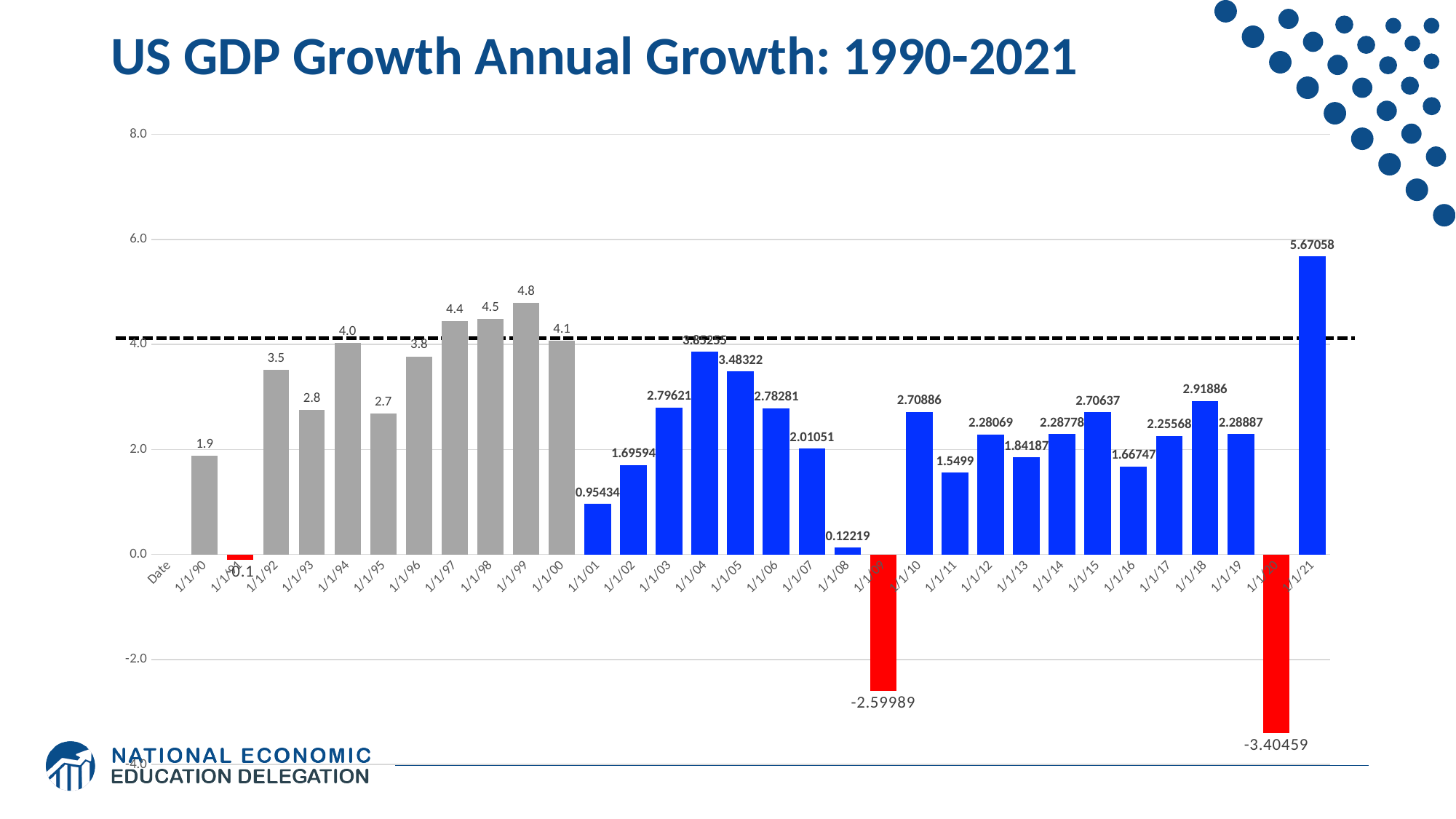
Which is larger, the value for 1/1/18 or the value for 1/1/17? 1/1/18 What is the difference between the values for 1/1/99 and 1/1/90? 2.9 What colour are the bars with negative values? red How many years (bars) are plotted on the chart? 32 Is the value for 1/1/97 greater or less than 4.0? greater What is the value for 1/1/99? 4.8 What kind of chart is shown on the slide? bar chart What is the value for 1/1/08? 0.12219 Which year has the highest GDP growth value? 1/1/21 What is the value for 1/1/09? -2.59989 Which year has the lowest GDP growth value? 1/1/20 What is the value for 1/1/21? 5.67058